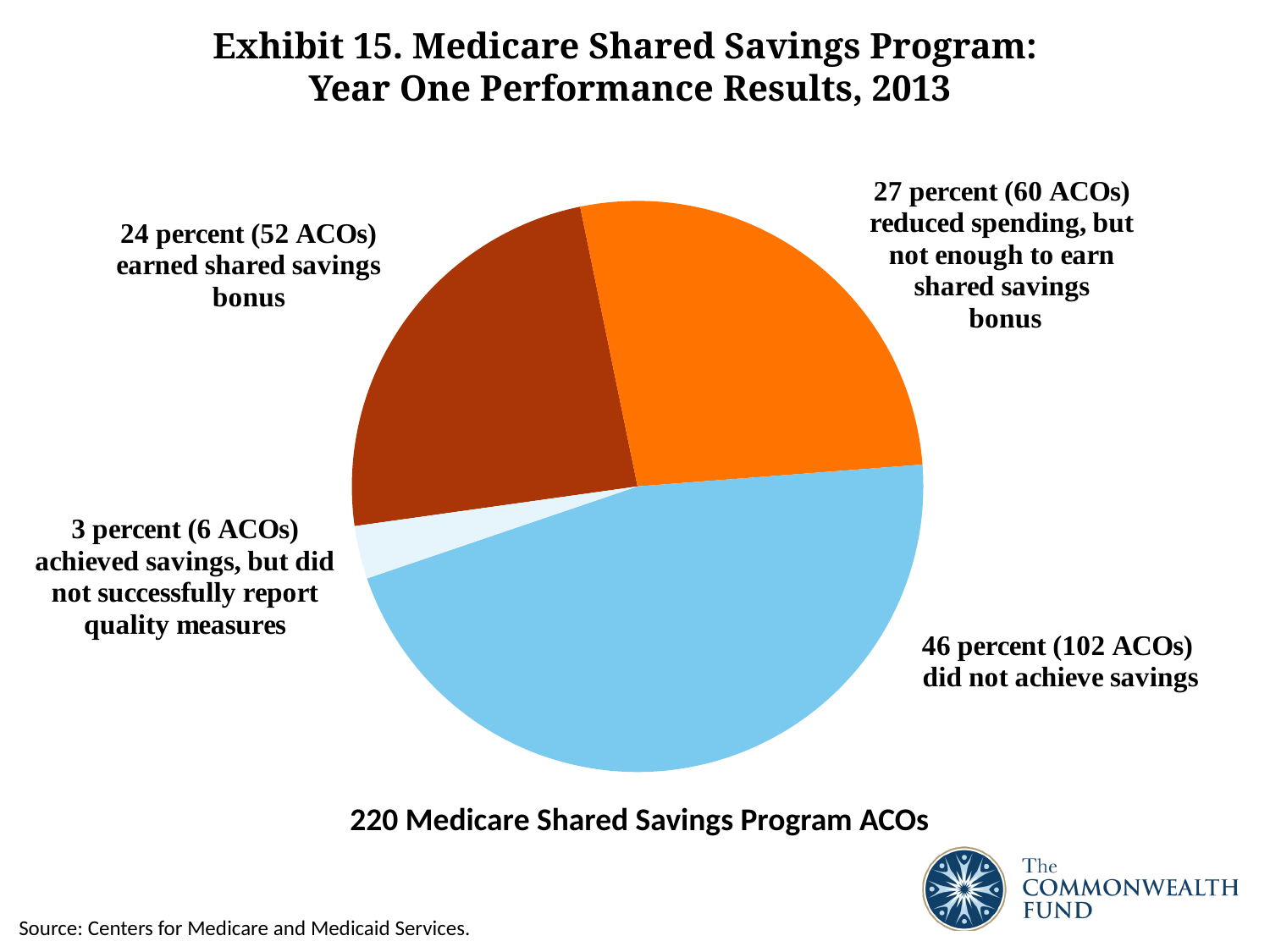
How many more ACOs did not achieve savings than earned a shared savings bonus? 50 Which is larger: the share of ACOs that earned a shared savings bonus or the share that reduced spending but not enough to earn a bonus? Reduced spending, but not enough to earn shared savings bonus What kind of chart is shown on the slide? Pie chart Which category represents the largest share of the pie? Did not achieve savings What is the title of the chart? Exhibit 15. Medicare Shared Savings Program: Year One Performance Results, 2013 What percentage of ACOs did not achieve savings? 46 percent Which category represents the smallest share of the pie? Achieved savings, but did not successfully report quality measures How many ACOs earned a shared savings bonus? 52 ACOs How many slices does the pie chart have? 4 How many ACOs reduced spending but not enough to earn a shared savings bonus? 60 ACOs What percentage of ACOs achieved savings but did not successfully report quality measures? 3 percent What is the total number of Medicare Shared Savings Program ACOs shown below the chart? 220